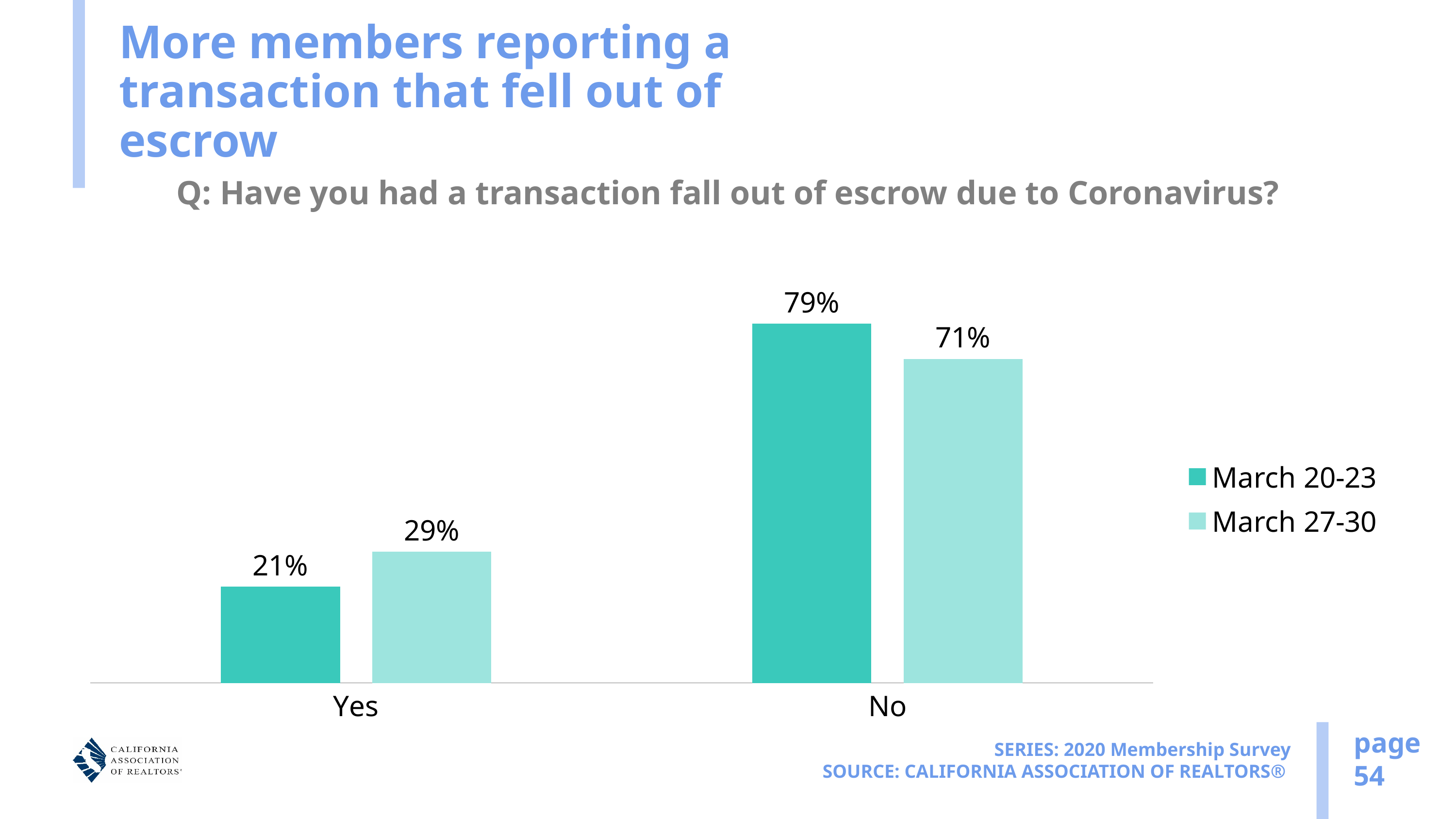
Which response category has the lowest value in the March 27-30 series? Yes What is the difference between the No values for March 20-23 and March 27-30? 8 percentage points Which survey period has the larger Yes value, March 20-23 or March 27-30? March 27-30 Which response category has the highest value in the March 20-23 series? No What percentage of members answered No in the March 20-23 survey? 79% What percentage of members answered Yes in the March 20-23 survey? 21% How many response categories are shown on the x axis? 2 What percentage of members answered No in the March 27-30 survey? 71% By how many percentage points did the Yes response increase from March 20-23 to March 27-30? 8 percentage points How many series does the legend list? 2 What kind of chart is shown on the slide? Bar chart What percentage of members answered Yes in the March 27-30 survey? 29%